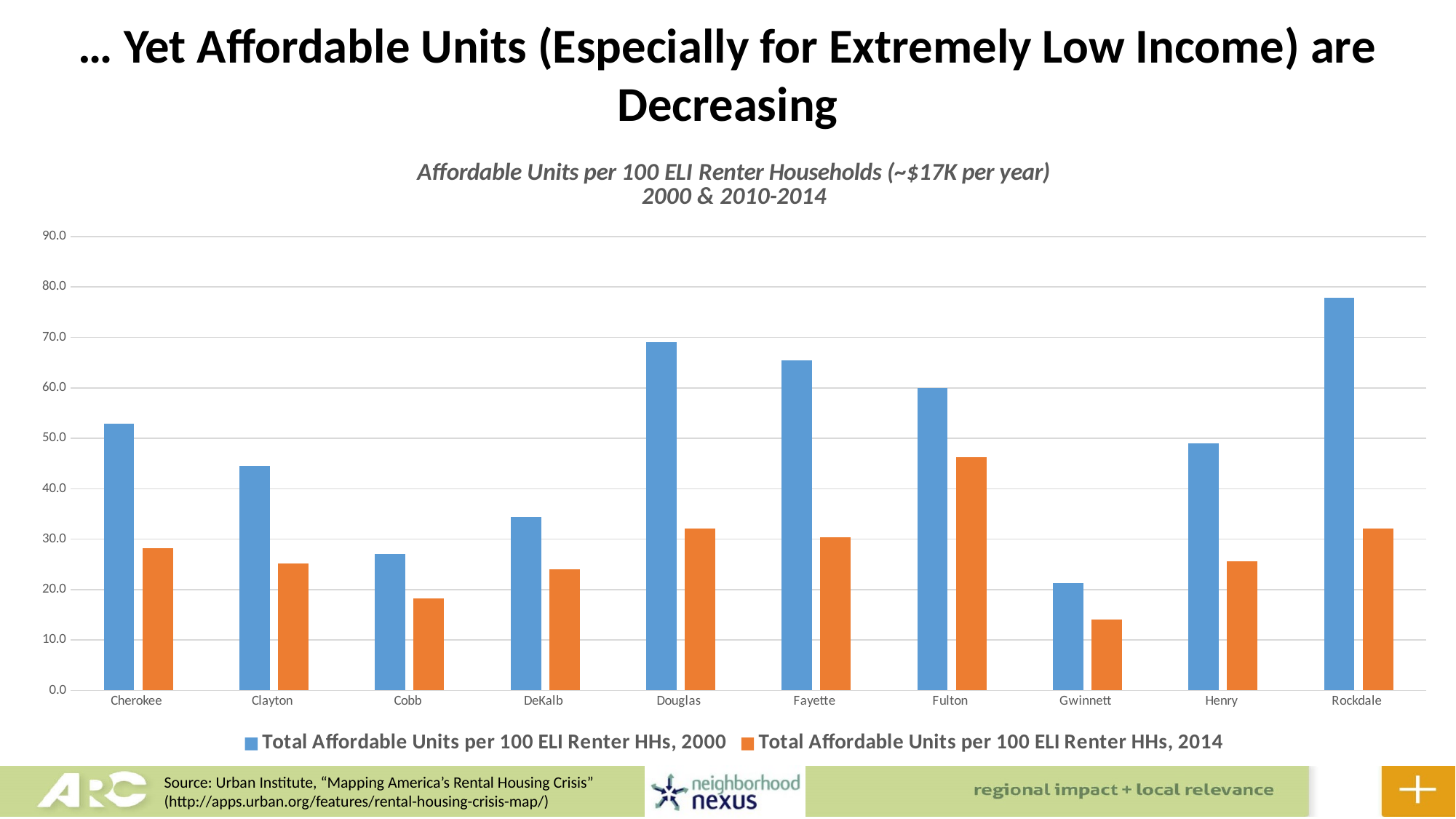
For Fulton, which is larger: the 2000 value or the 2014 value? 2000 How many series does the legend list? 2 Which county has the lowest Total Affordable Units per 100 ELI Renter HHs in 2014? Gwinnett Which county has the highest Total Affordable Units per 100 ELI Renter HHs in 2014? Fulton Is the 2000 value for Douglas greater or less than 60.0? greater What kind of chart is shown on the slide? Bar chart Is the 2014 value for Cobb greater or less than 20.0? less What colour are the bars for Total Affordable Units per 100 ELI Renter HHs, 2014? Orange How many counties are shown on the x axis of the chart? 10 Is the 2000 value for Rockdale greater or less than 70.0? greater Which county has the highest Total Affordable Units per 100 ELI Renter HHs in 2000? Rockdale Which county has the lowest Total Affordable Units per 100 ELI Renter HHs in 2000? Gwinnett